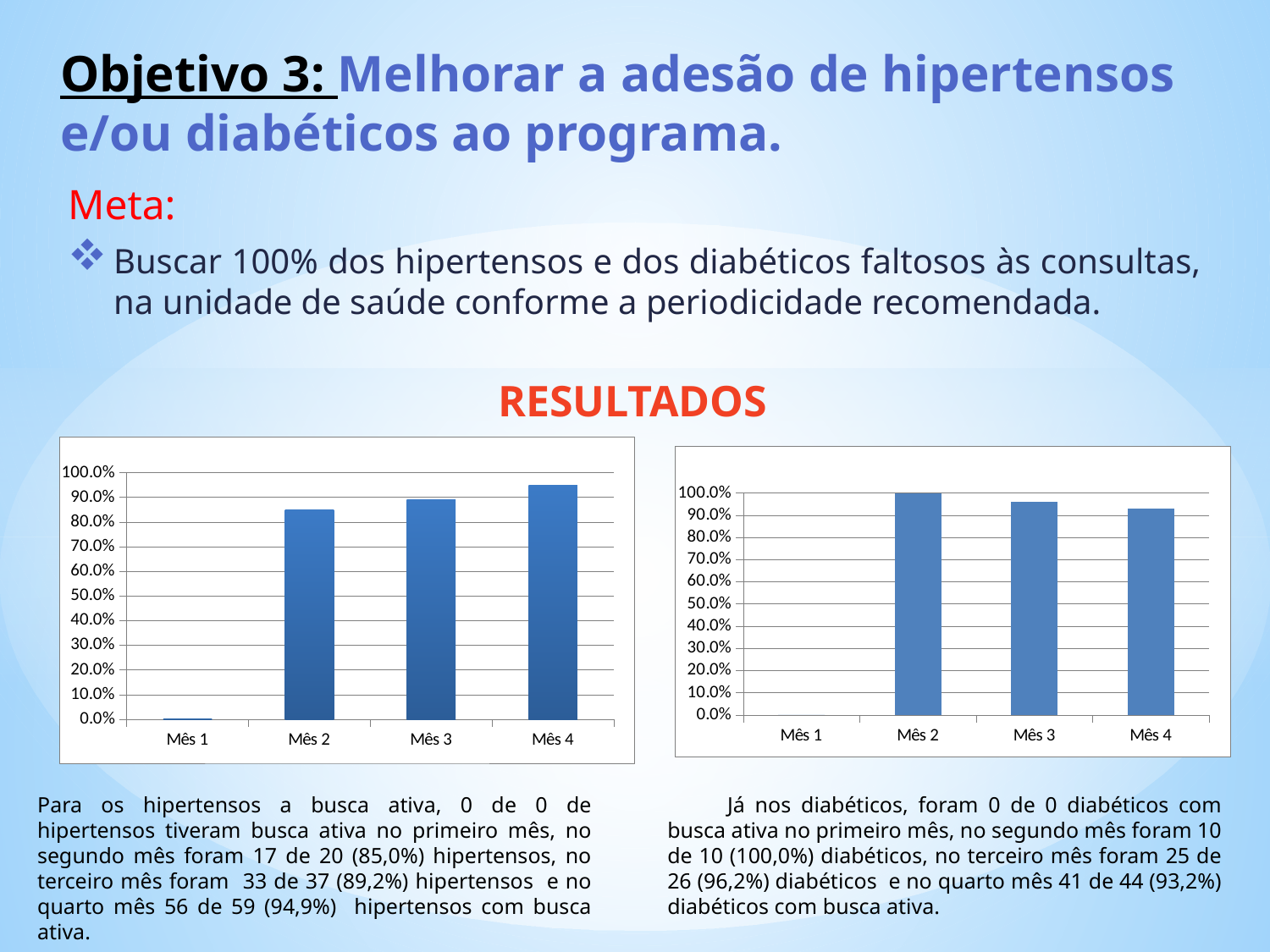
In the right chart, what is the value for Mês 2? 100.0% In the left chart, which month has the highest bar? Mês 4 How many categories are shown on the x axis of the left chart? 4 What kind of chart is the left chart? bar chart In the left chart, is the value for Mês 2 greater or less than 80.0%? greater In the right chart, which is larger, the value for Mês 2 or the value for Mês 4? Mês 2 In the right chart, which month has the lowest bar? Mês 1 In the left chart, what is the value for Mês 1? 0.0% In the left chart, is the value for Mês 4 greater or less than 90.0%? greater In the right chart, is the value for Mês 4 greater or less than 90.0%? greater In the right chart, which month has the highest bar? Mês 2 In the left chart, which month has the lowest bar? Mês 1